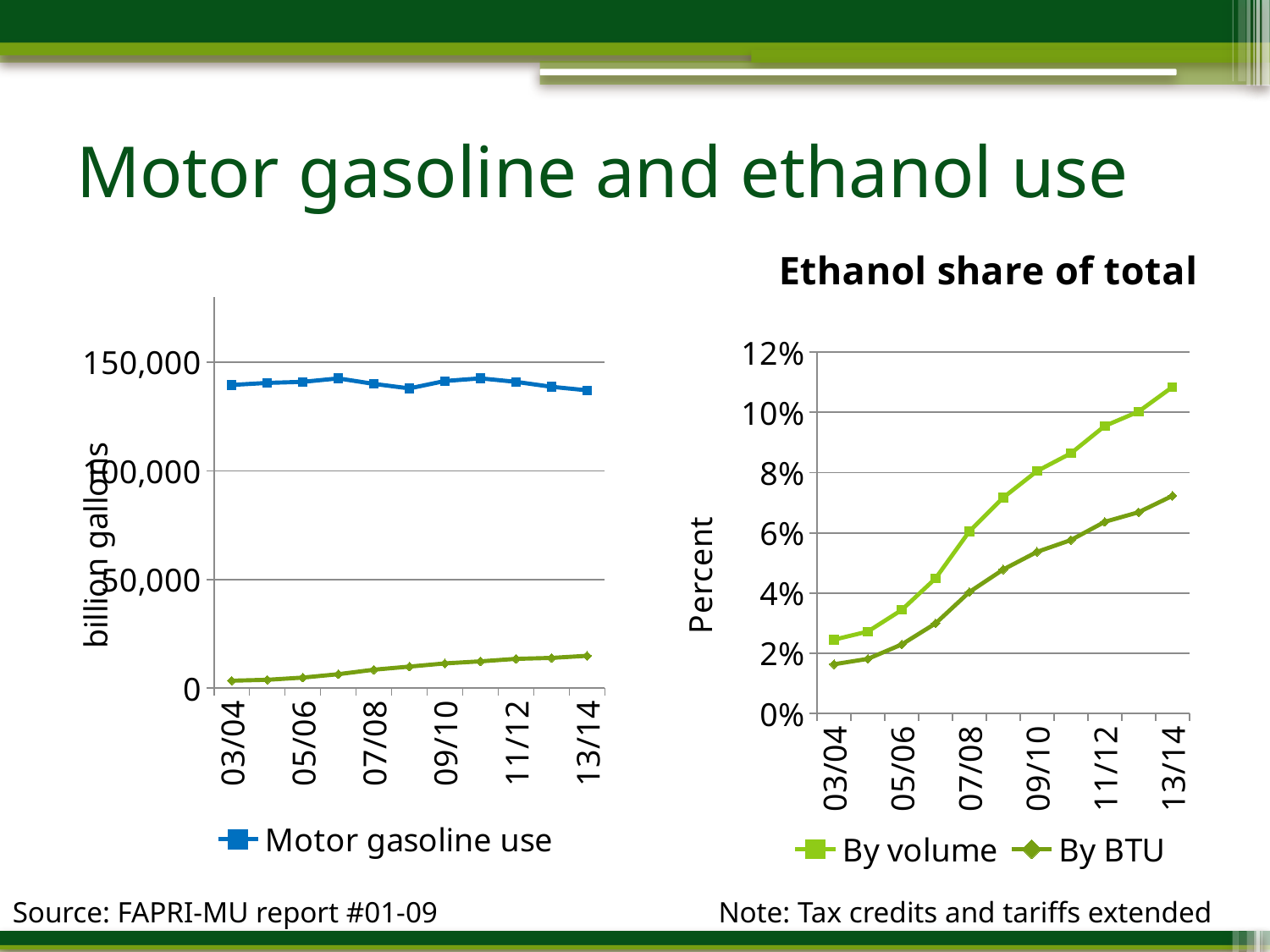
In the left chart, is the 'Motor gasoline use' value for 03/04 greater or less than 150,000? less In the 'Ethanol share of total' chart, in which year is the 'By BTU' series at its lowest? 03/04 In the 'Ethanol share of total' chart, is the 'By BTU' value for 13/14 greater or less than 8%? less In the 'Ethanol share of total' chart, does the 'By volume' series rise or fall from 03/04 to 13/14? rise In the left chart, what is the y-axis label? billion gallons In the 'Ethanol share of total' chart, is the 'By BTU' value for 03/04 greater or less than 2%? less In the 'Ethanol share of total' chart, how many series does the legend list? 2 In the 'Ethanol share of total' chart, which series is higher in 13/14, 'By volume' or 'By BTU'? By volume In the left chart, how many entries does the legend list? 1 In the 'Ethanol share of total' chart, in which year is the 'By volume' series at its highest? 13/14 What kind of chart is the 'Ethanol share of total' chart? line chart